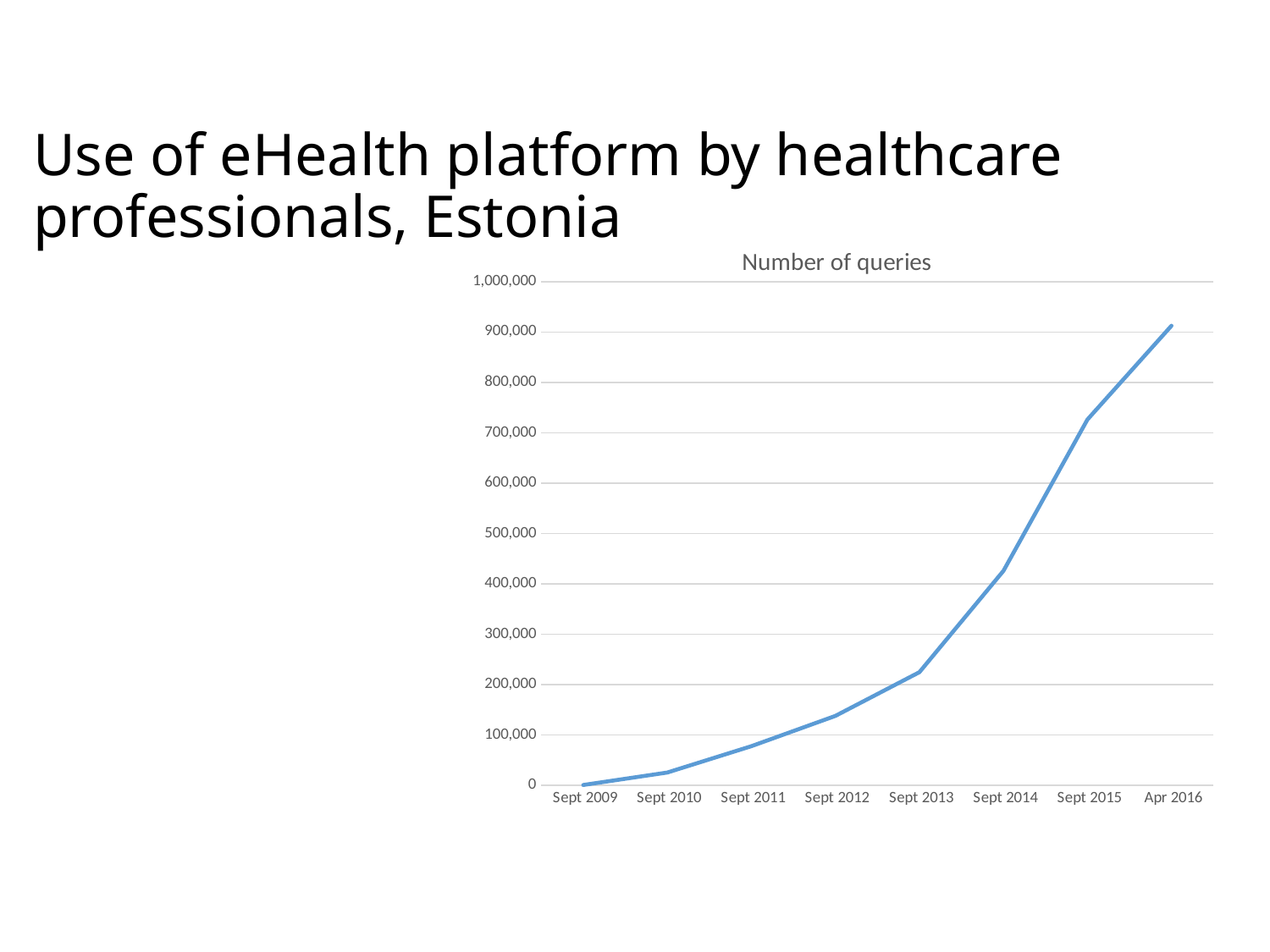
Is the value for Sept 2012 greater or less than 100,000? greater Is the value for Sept 2015 greater or less than 600,000? greater Which time point has the highest number of queries? Apr 2016 What is the title of the chart? Number of queries What kind of chart is shown on the slide? line chart Which is larger, the value for Sept 2013 or the value for Sept 2014? Sept 2014 Is the value for Apr 2016 greater or less than 800,000? greater How many time points are plotted on the x axis? 8 Do the values rise or fall from Sept 2009 to Apr 2016? rise Which time point has the lowest number of queries? Sept 2009